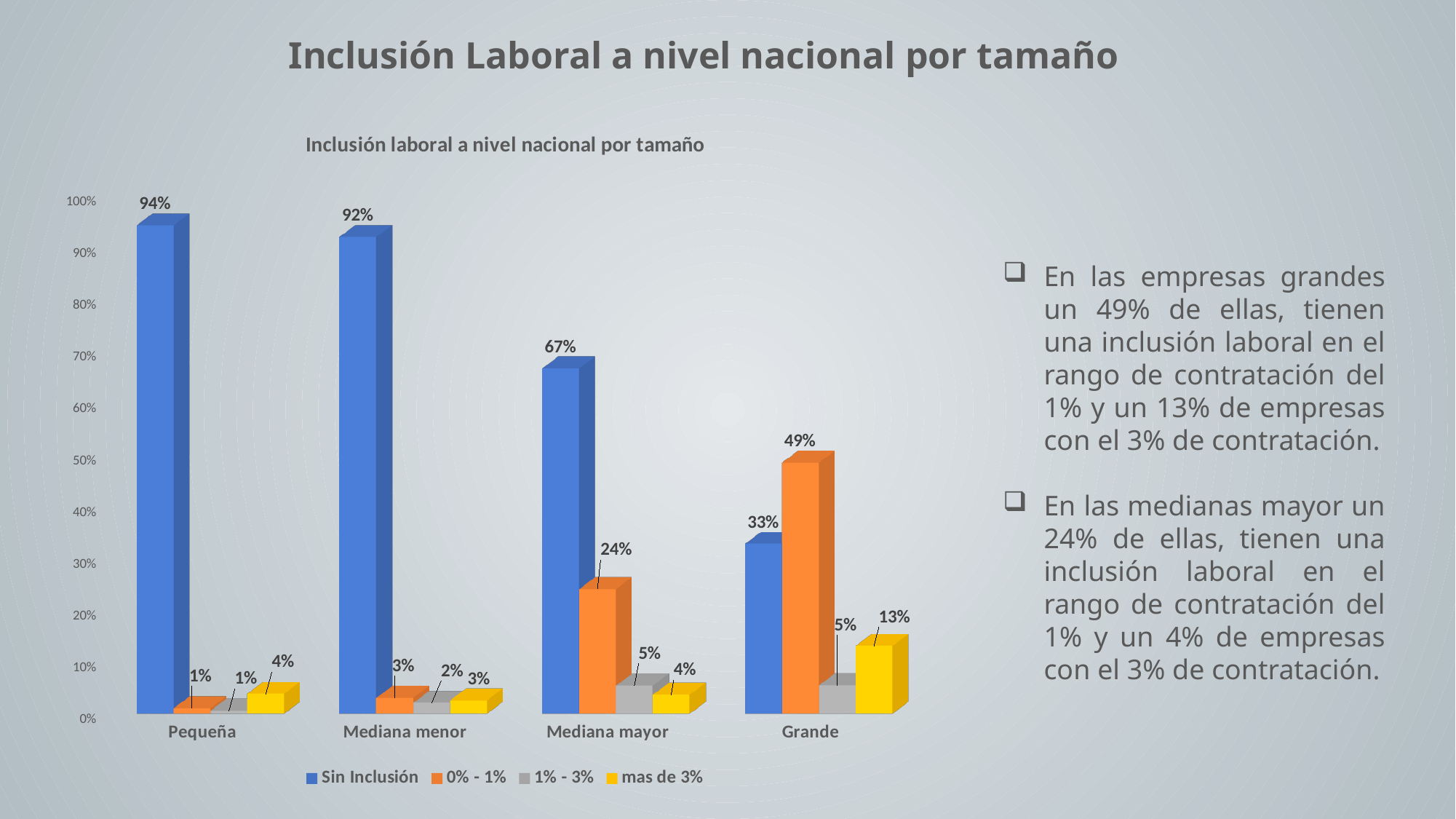
Which category has the lowest 'Sin Inclusión' value? Grande What is the value of 'mas de 3%' for Mediana mayor? 4% How many categories are shown on the x axis? 4 How many series does the legend list? 4 Which is larger for Grande: 'Sin Inclusión' or '0% - 1%'? 0% - 1% What is the value of '0% - 1%' for Grande? 49% Does the 'Sin Inclusión' series rise or fall from Pequeña to Grande? Fall What is the value of 'Sin Inclusión' for Pequeña? 94% What is the difference between the 'Sin Inclusión' values for Mediana menor and Mediana mayor? 25% Which category has the highest 'Sin Inclusión' value? Pequeña What kind of chart is shown? Bar chart What is the value of '1% - 3%' for Mediana menor? 2%